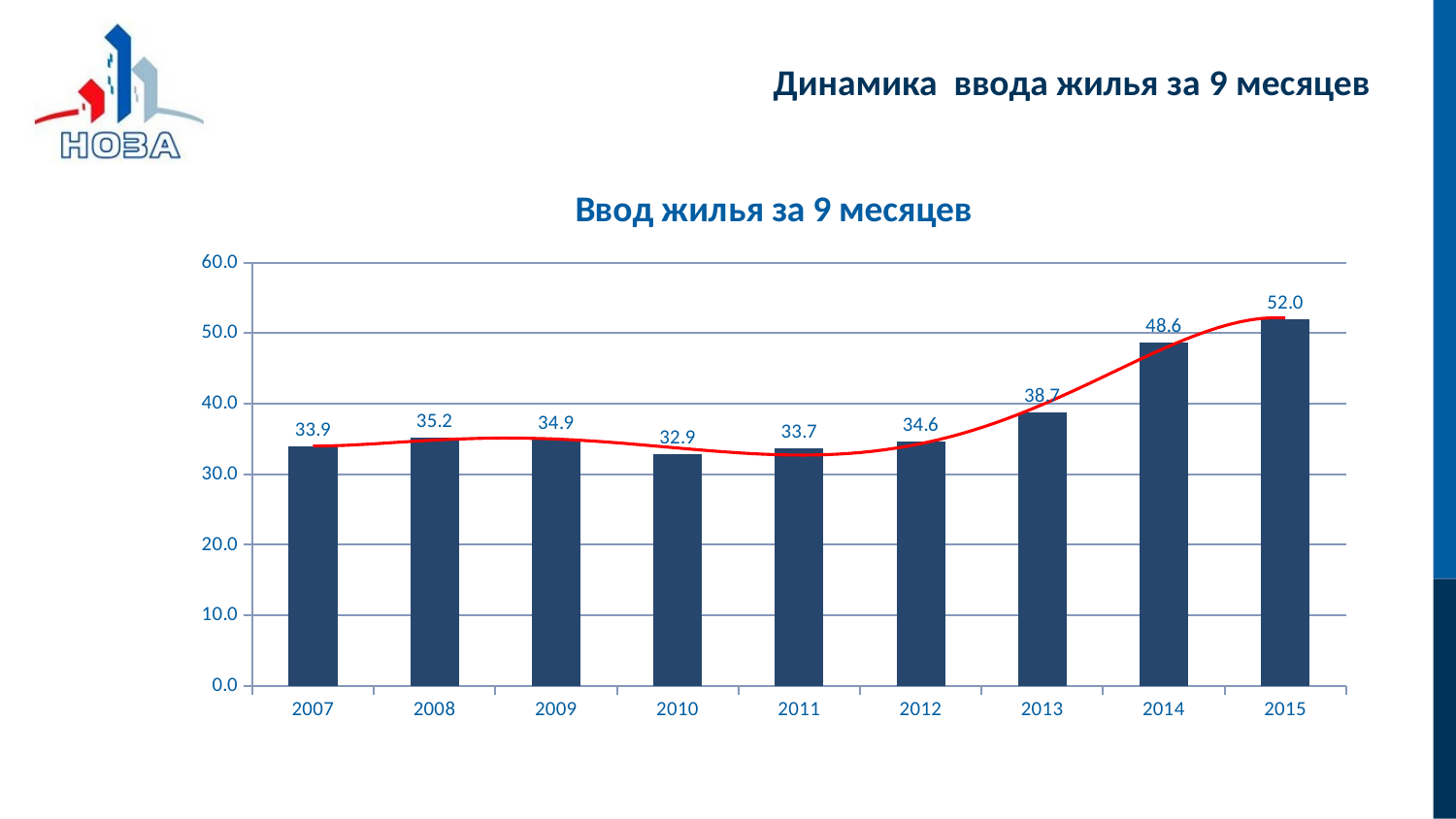
What is the value for 2010? 32.9 Which is larger, the value for 2008 or the value for 2011? 2008 What is the difference between the values for 2013 and 2012? 4.1 Which year has the highest value? 2015 What is the value for 2015? 52.0 What is the title of the chart? Ввод жилья за 9 месяцев What is the value for 2013? 38.7 How many years are shown on the x axis? 9 Is the value for 2014 greater or less than 40.0? greater Which year has the lowest value? 2010 What is the difference between the values for 2015 and 2014? 3.4 What kind of chart is this? bar chart